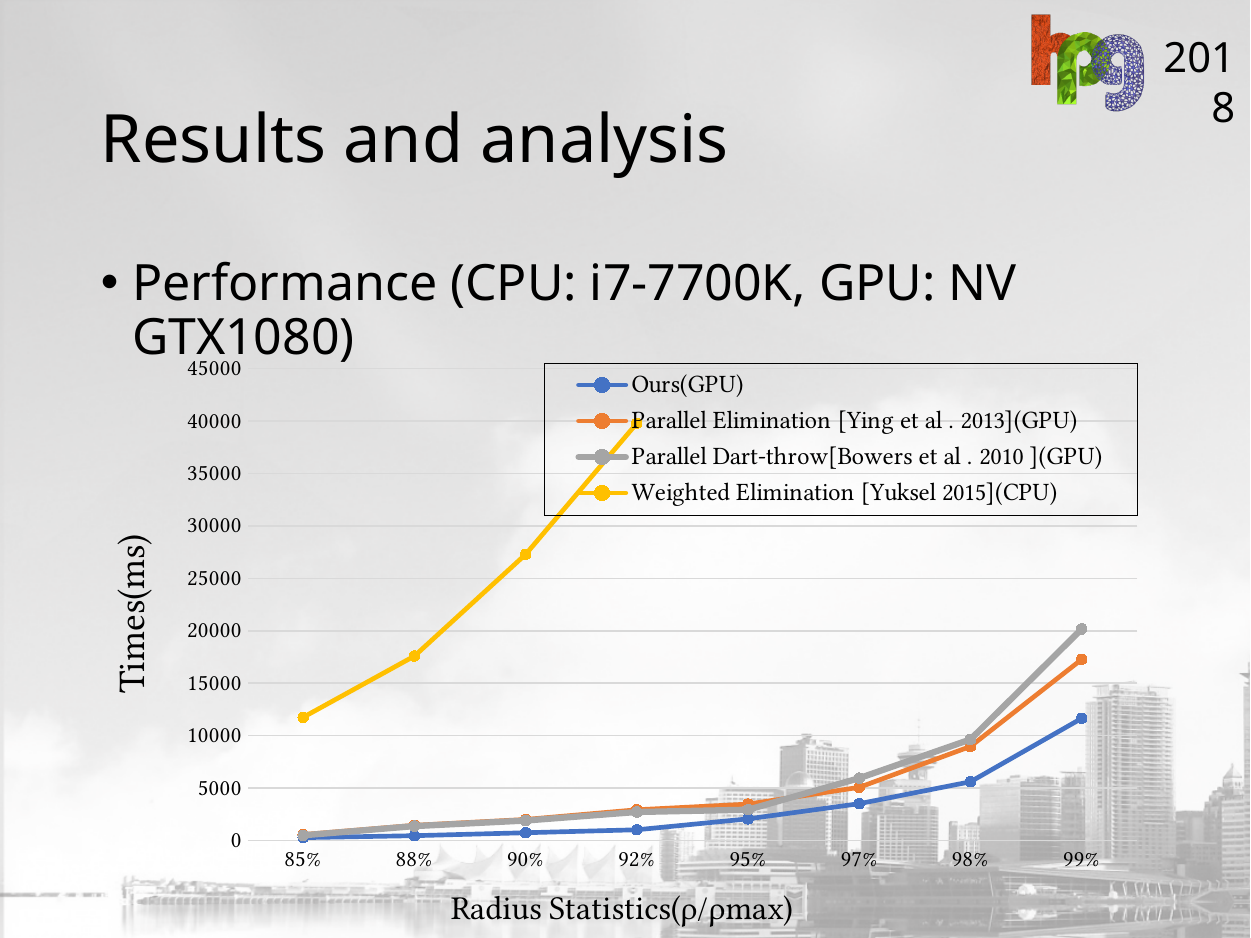
How many series does the legend list? 4 How many radius statistics categories are plotted along the x axis? 8 What is the label of the y axis? Times(ms) At 99%, which is larger: Parallel Dart-throw[Bowers et al. 2010](GPU) or Parallel Elimination [Ying et al. 2013](GPU)? Parallel Dart-throw[Bowers et al. 2010](GPU) Do the values for Ours(GPU) rise or fall as the radius statistic increases from 85% to 99%? rise Is the value for Parallel Elimination [Ying et al. 2013](GPU) at 99% greater or less than 15000? greater Is the value for Weighted Elimination [Yuksel 2015](CPU) at 90% greater or less than 25000? greater Which series has the lowest time at 99%? Ours(GPU) What kind of chart is shown on the slide? line chart Is the value for Weighted Elimination [Yuksel 2015](CPU) at 85% greater or less than 10000? greater Which series has the highest time at 85%? Weighted Elimination [Yuksel 2015](CPU)